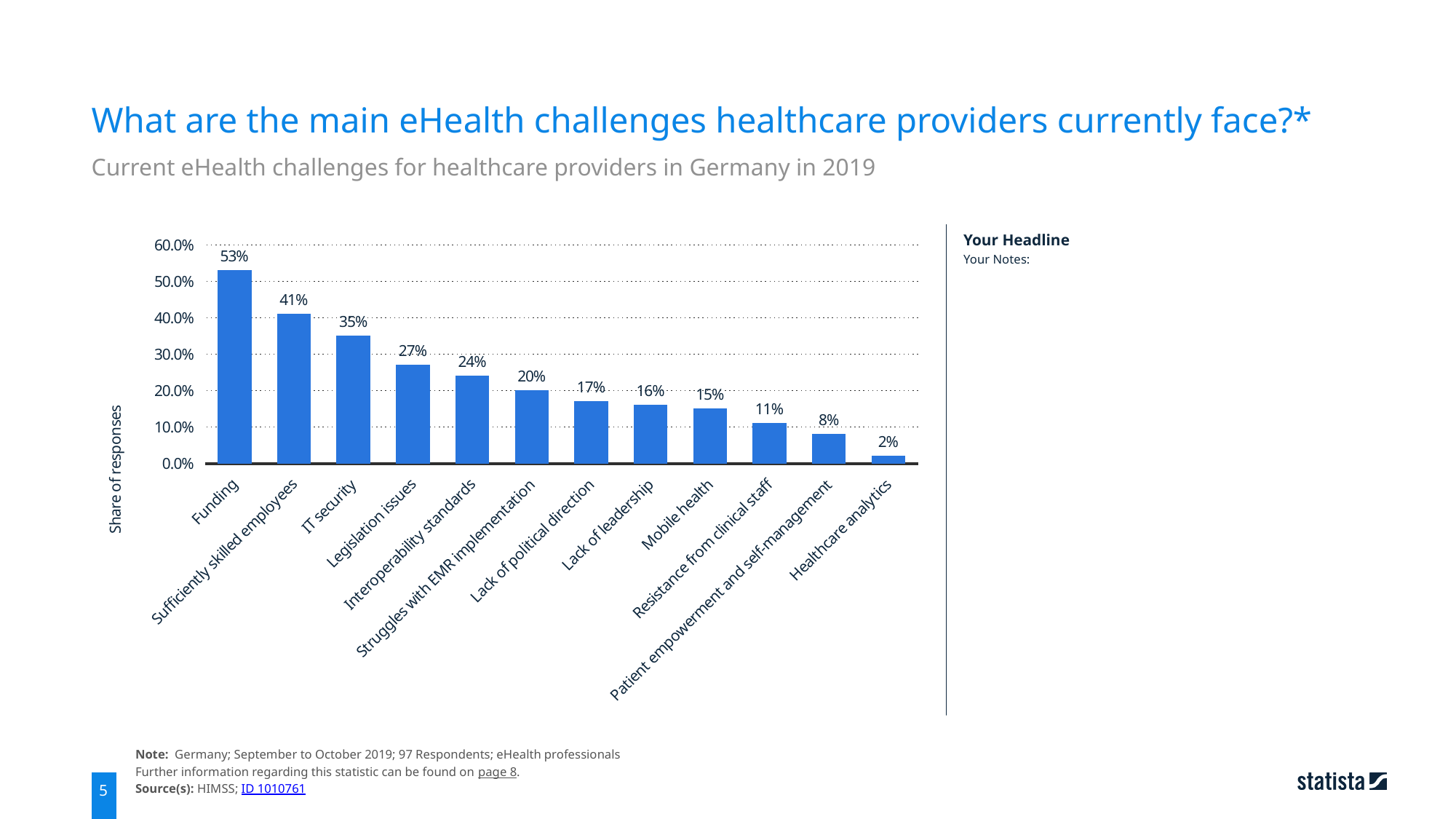
Which challenge has the highest share of responses? Funding What share of responses is shown for Mobile health? 15% Do the values rise or fall from left to right along the x axis? fall What share of responses is shown for IT security? 35% What share of responses is shown for Funding? 53% Which challenge has the lowest share of responses? Healthcare analytics Is the value for Lack of political direction greater or less than 20.0%? less What kind of chart is shown on the slide? bar chart How many challenges are shown in the chart? 12 What is the label of the vertical axis? Share of responses Which has a larger share of responses, Legislation issues or Interoperability standards? Legislation issues What is the difference between the shares for Funding and Sufficiently skilled employees? 12%